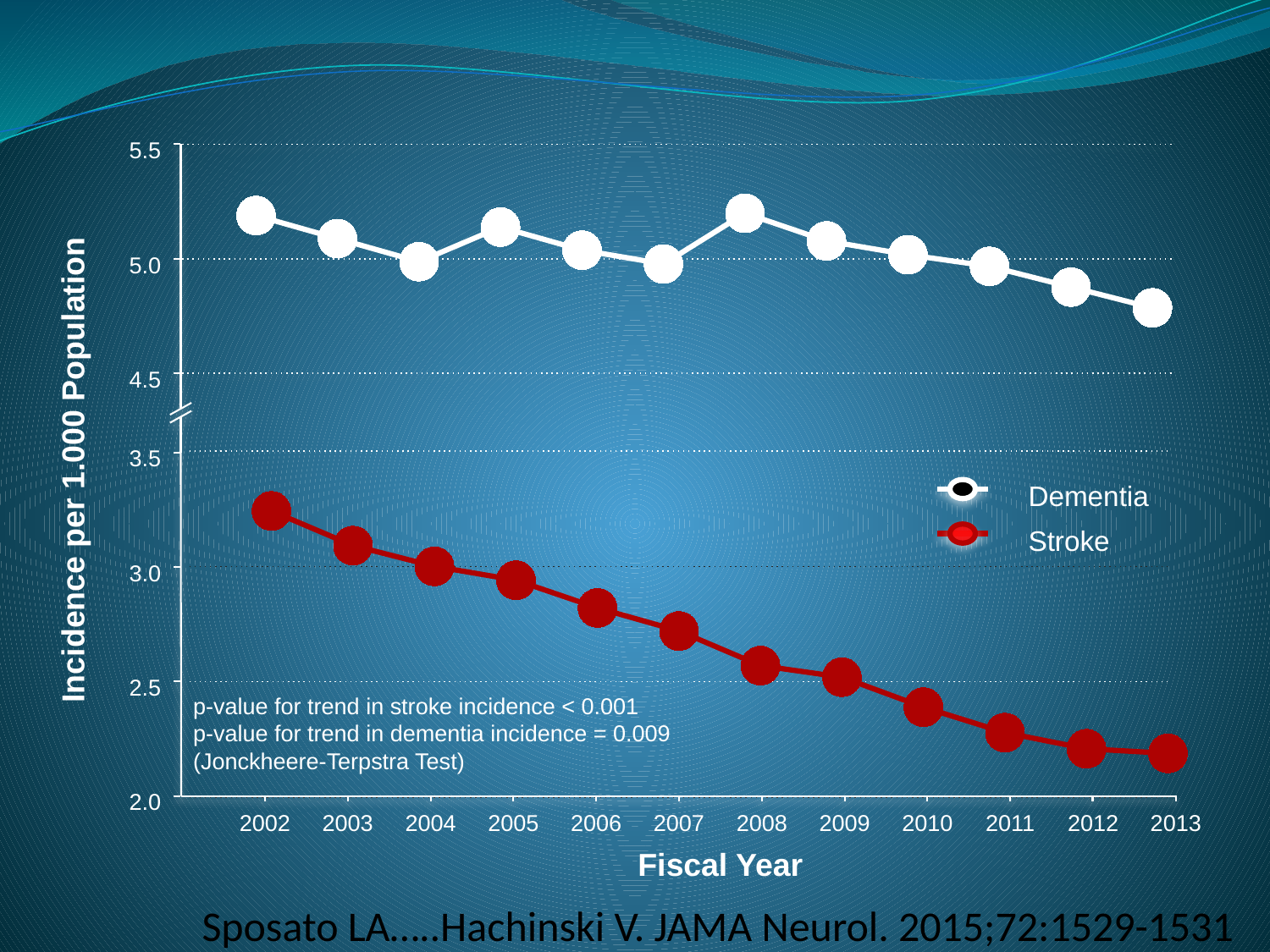
Does the Stroke incidence rise or fall from 2002 to 2013? Fall Which two series are listed in the legend? Dementia and Stroke Is the Stroke value for 2013 greater or less than 2.5? less How many series does the legend list? 2 Which year has the highest Stroke incidence? 2002 What is the title of the x axis? Fiscal Year What kind of chart is shown on the slide? Line chart How many fiscal years are plotted along the x axis? 12 Does the Dementia incidence overall rise or fall from 2002 to 2013? Fall Is the Stroke value for 2002 greater or less than 3.0? greater In 2008, which series has the larger value, Dementia or Stroke? Dementia Is the Dementia value for 2013 greater or less than 5.0? less